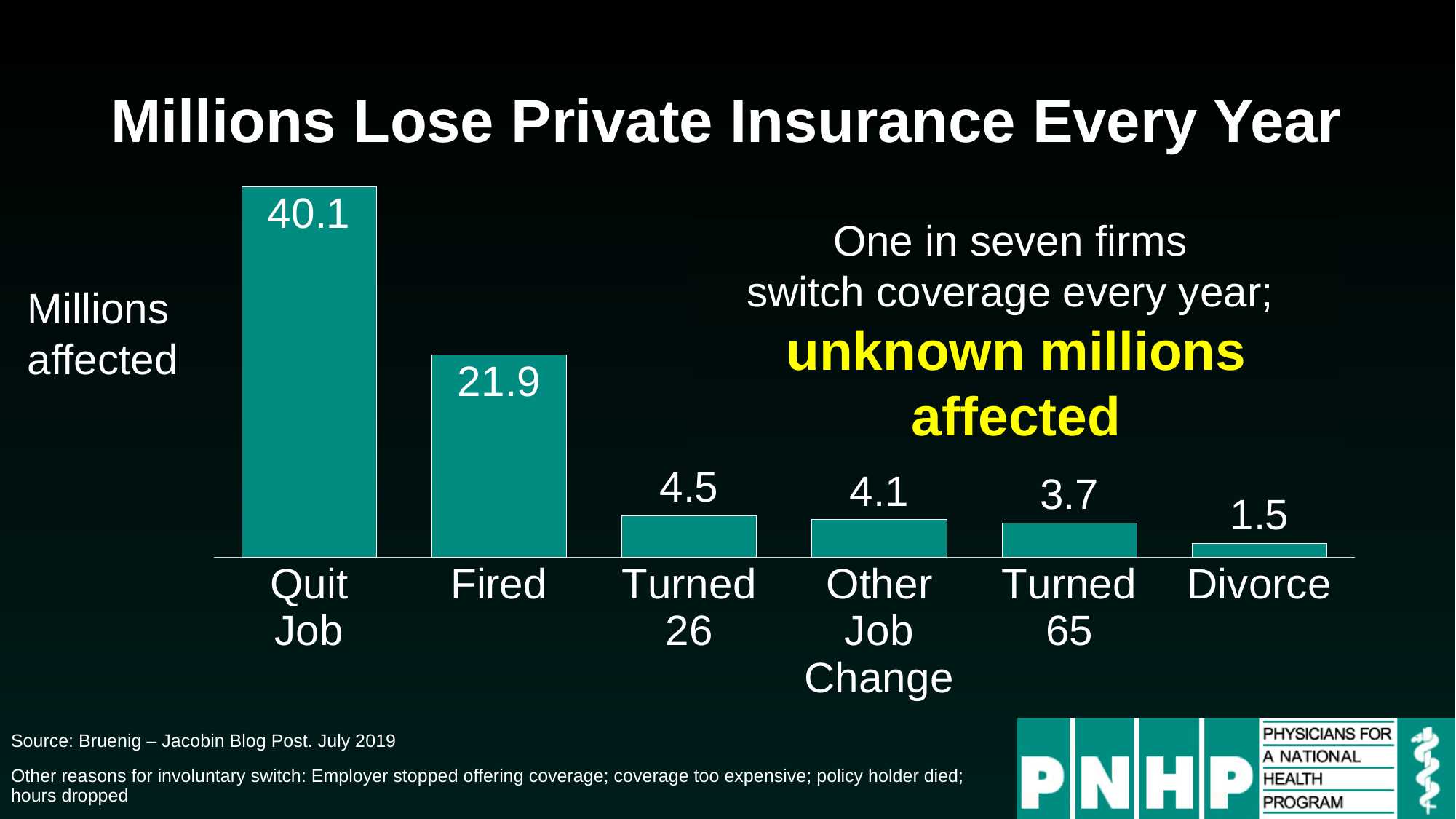
What is the title of the slide? Millions Lose Private Insurance Every Year What is the value for Divorce? 1.5 Which is larger, the value for Other Job Change or the value for Turned 65? Other Job Change Which category has the lowest value? Divorce What is the value for Quit Job? 40.1 What is the difference between the values for Quit Job and Fired? 18.2 What is the difference between the values for Turned 26 and Turned 65? 0.8 Which category has the highest value? Quit Job What is the value for Turned 26? 4.5 What kind of chart is shown on the slide? Bar chart How many categories are shown in the chart? 6 What is the value for Fired? 21.9